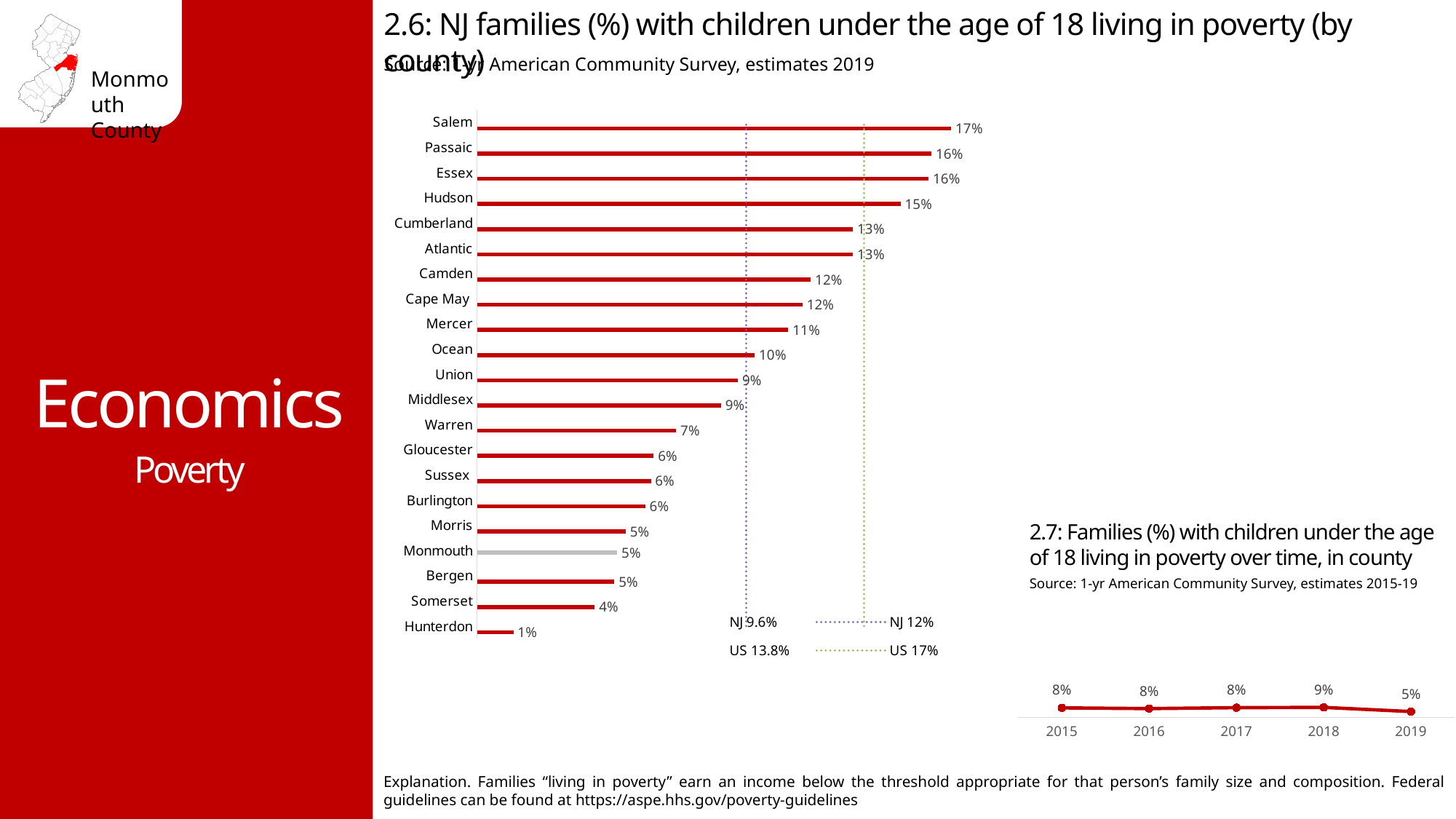
What kind of chart is chart 2.6? Bar chart In chart 2.6, what is the difference between the values for Salem and Hunterdon? 16% In chart 2.6, which county has the highest value? Salem In chart 2.7, how many years are plotted? 5 In chart 2.6, what is the value for Ocean? 10% In chart 2.7, which year has the highest value? 2018 In chart 2.6, which county has the lowest value? Hunterdon In chart 2.6, what is the value for Monmouth? 5% In chart 2.6, which is larger, the value for Hudson or the value for Mercer? Hudson In chart 2.6, how many counties are plotted? 21 In chart 2.7, what is the value for 2019? 5% In chart 2.7, what is the difference between the values for 2018 and 2019? 4%